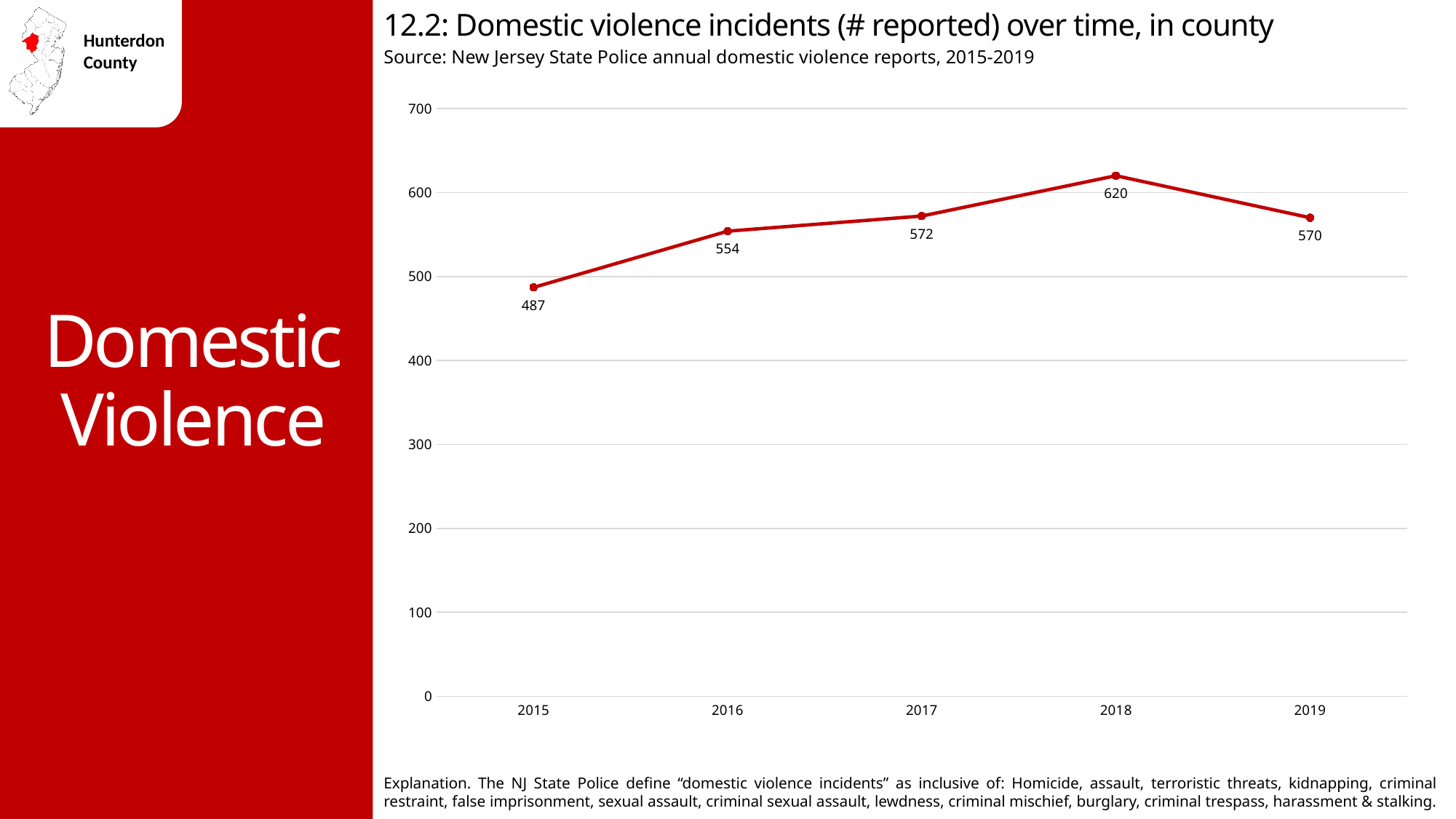
What is the number of reported domestic violence incidents for 2018? 620 Which year has the highest number of reported domestic violence incidents? 2018 How many years are plotted on the chart? 5 What is the difference between the 2018 and 2015 values? 133 Which year had more reported incidents, 2016 or 2017? 2017 Which year has the lowest number of reported domestic violence incidents? 2015 What kind of chart is shown on the slide? line chart Do the values rise or fall from 2015 to 2018? rise How many domestic violence incidents were reported in 2015? 487 What value is shown for 2019? 570 By how much did reported incidents change from 2018 to 2019? 50 Is the value for 2015 greater or less than 500? less